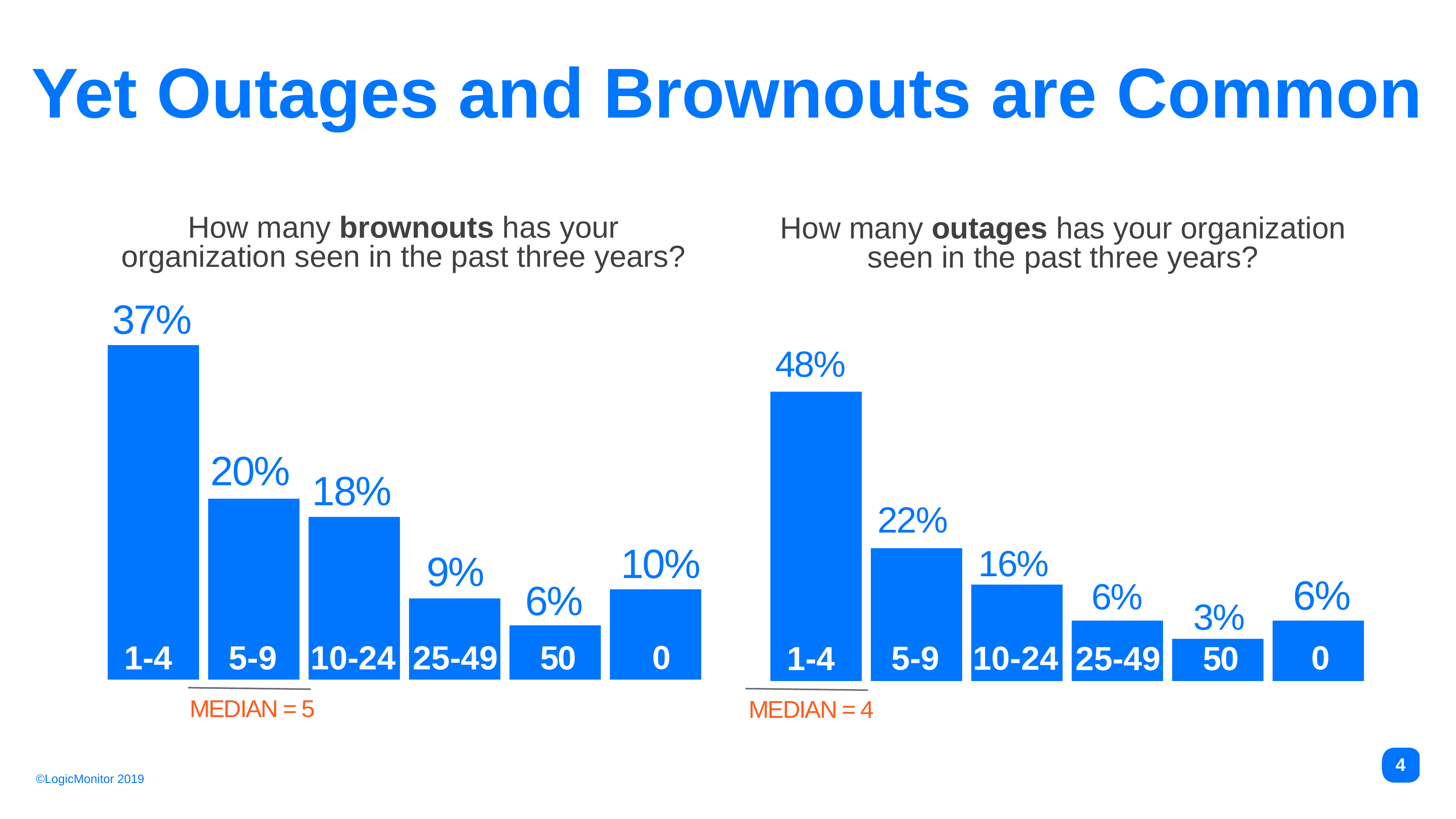
In the outages chart, what is the difference between the 1-4 and 10-24 percentages? 32% In the outages chart, what percentage of organizations saw 5-9 outages? 22% What type of chart is used for the outages data? Bar chart In the brownouts chart, what is the difference between the 1-4 and 5-9 percentages? 17% How many categories are shown in the brownouts chart? 6 What median value is shown below the outages chart? MEDIAN = 4 In the outages chart, what percentage of organizations saw 50 outages? 3% In the outages chart, which category has the lowest percentage? 50 In the brownouts chart, what percentage of organizations saw 1-4 brownouts in the past three years? 37% What median value is shown below the brownouts chart? MEDIAN = 5 In the brownouts chart, which category has the highest percentage? 1-4 Which is larger: the 0 category in the brownouts chart or the 0 category in the outages chart? Brownouts chart (10%)